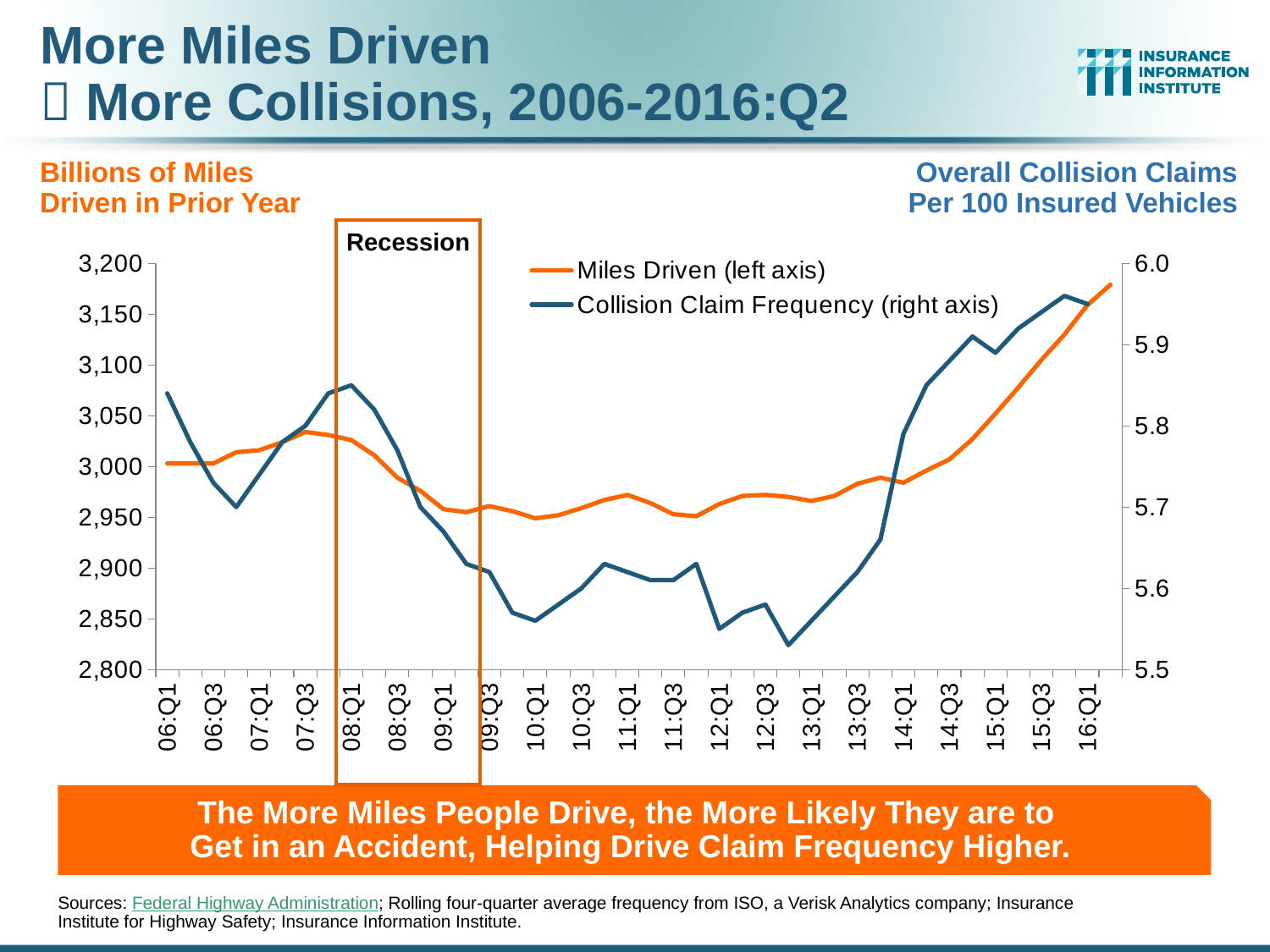
Does Miles Driven rise or fall from 12:Q1 to 16:Q1? rise Is the value for Collision Claim Frequency at 06:Q3 greater or less than 5.8? less Is the value for Miles Driven at 10:Q1 greater or less than 3,000? less Is the value for Collision Claim Frequency at 12:Q3 greater or less than 5.6? less Which series is plotted against the right axis according to the legend? Collision Claim Frequency How many series does the chart legend list? 2 What period is marked by the orange box on the chart? Recession What kind of chart is shown on the slide? line chart